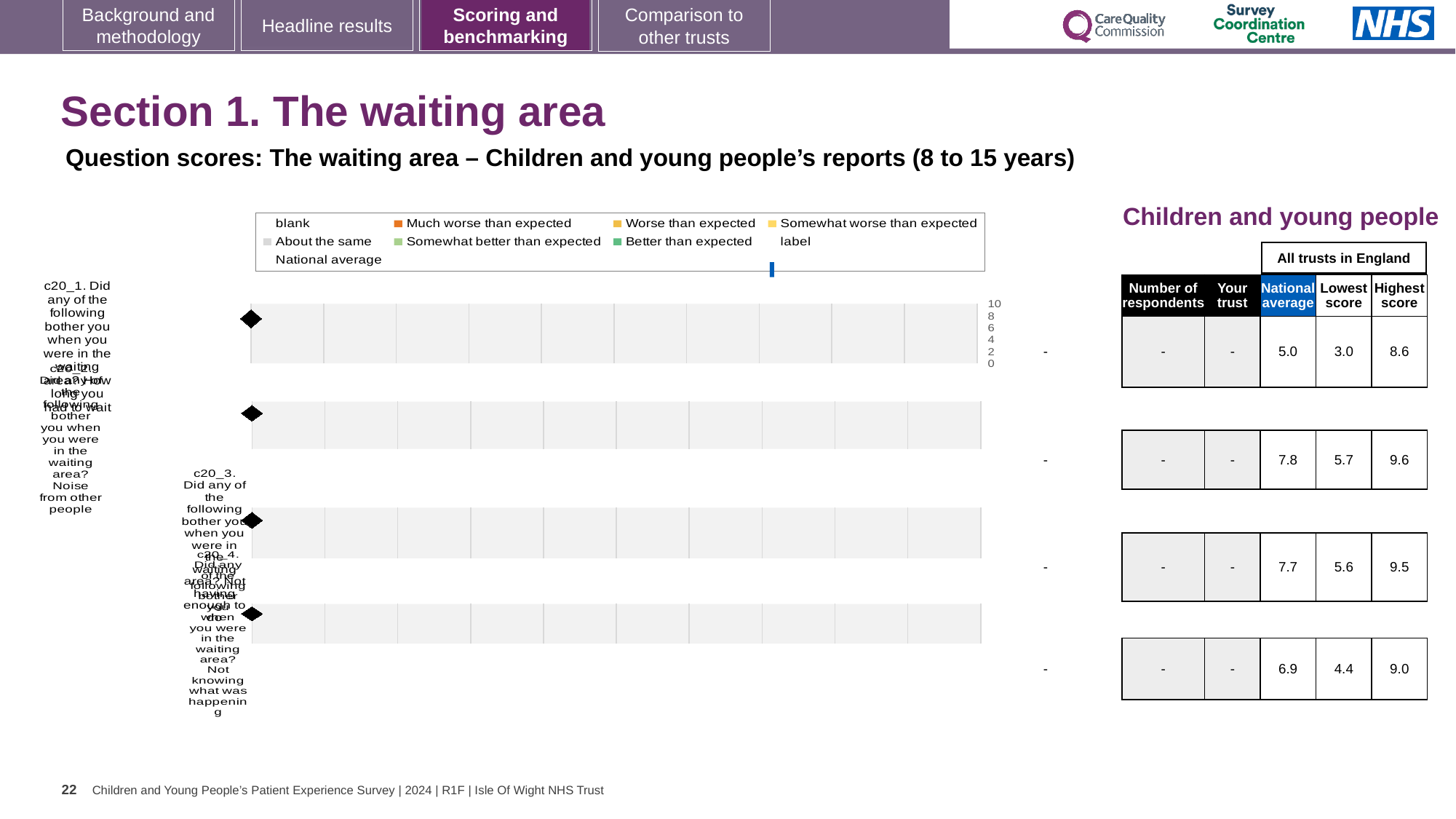
How many questions (categories) are plotted on the chart? 4 In the table to the right of the chart, which question has the highest national average? c20_2 (How long you had to wait) In the table to the right of the chart, what is the national average for c20_1 (Did any of the following bother you when you were in the waiting area? Noise from other people)? 5.0 What colour is the legend marker for "Much worse than expected"? orange What kind of chart is shown on the slide? bar chart In the table to the right of the chart, which has the larger national average: c20_3 (Not having enough to do) or c20_4 (Not knowing what was happening)? c20_3 In the table to the right of the chart, which question has the lowest national average? c20_1 (Noise from other people) In the table to the right of the chart, what is the difference between the highest score and the lowest score for c20_1? 5.6 In the table to the right of the chart, what is the lowest score for c20_4 (Not knowing what was happening)? 4.4 How many entries does the chart legend list? 9 In the table to the right of the chart, what is the highest score for c20_2 (How long you had to wait)? 9.6